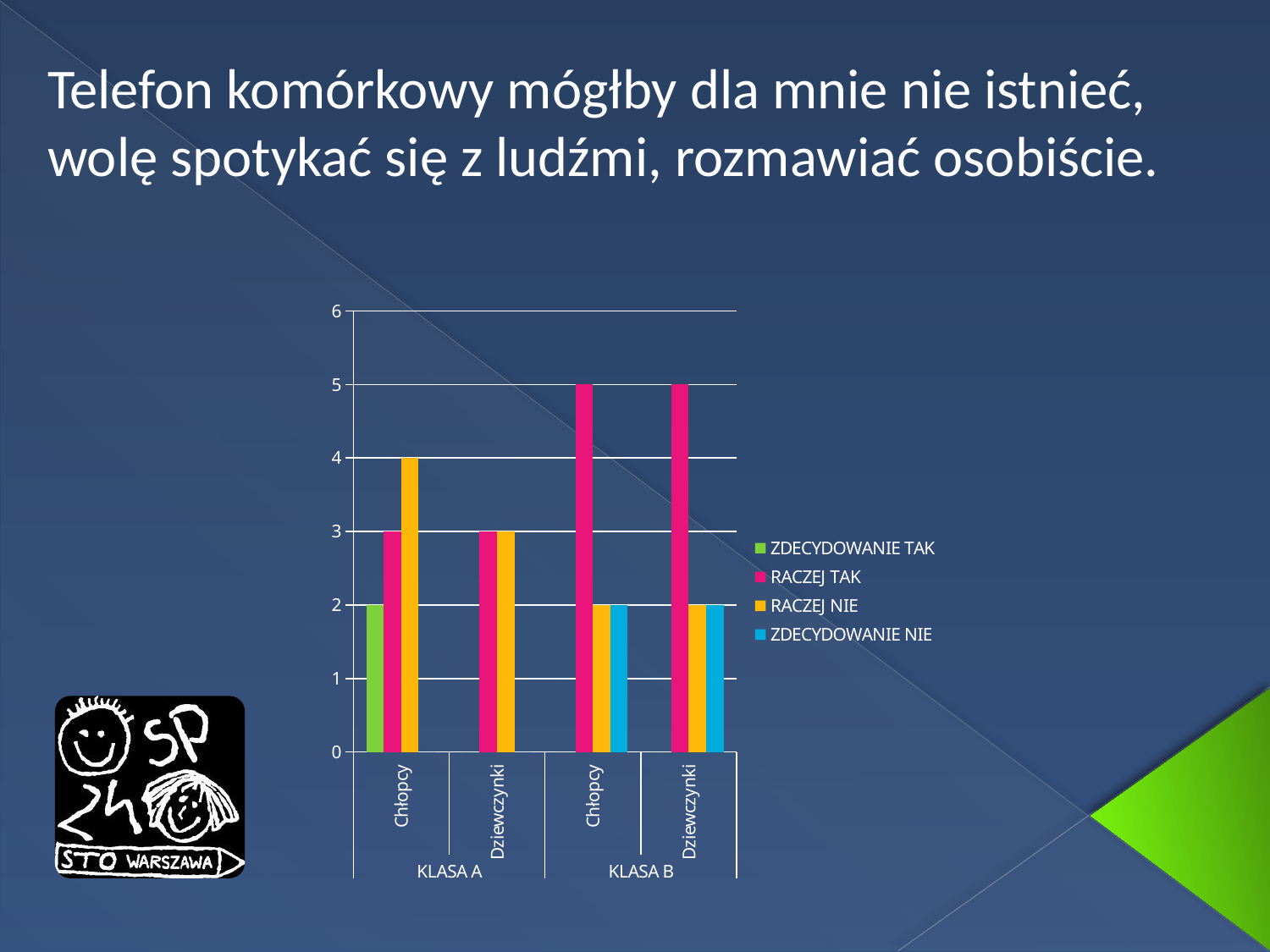
What is the difference between RACZEJ TAK for Dziewczynki in KLASA B and RACZEJ TAK for Dziewczynki in KLASA A? 2 What is the value of RACZEJ NIE for Chłopcy in KLASA A? 4 What is the value of RACZEJ TAK for Chłopcy in KLASA B? 5 Which series has the highest value for Chłopcy in KLASA A? RACZEJ NIE How many series does the legend list? 4 What kind of chart is shown on the slide? bar chart Is the value of RACZEJ TAK for Dziewczynki in KLASA B greater or less than 4? greater What is the value of ZDECYDOWANIE NIE for Dziewczynki in KLASA B? 2 Which is larger: RACZEJ TAK for Chłopcy in KLASA B or RACZEJ NIE for Chłopcy in KLASA B? RACZEJ TAK for Chłopcy in KLASA B What colour represents the RACZEJ TAK series in the legend? pink How many category groups are shown on the x axis? 4 What is the value of ZDECYDOWANIE TAK for Chłopcy in KLASA A? 2